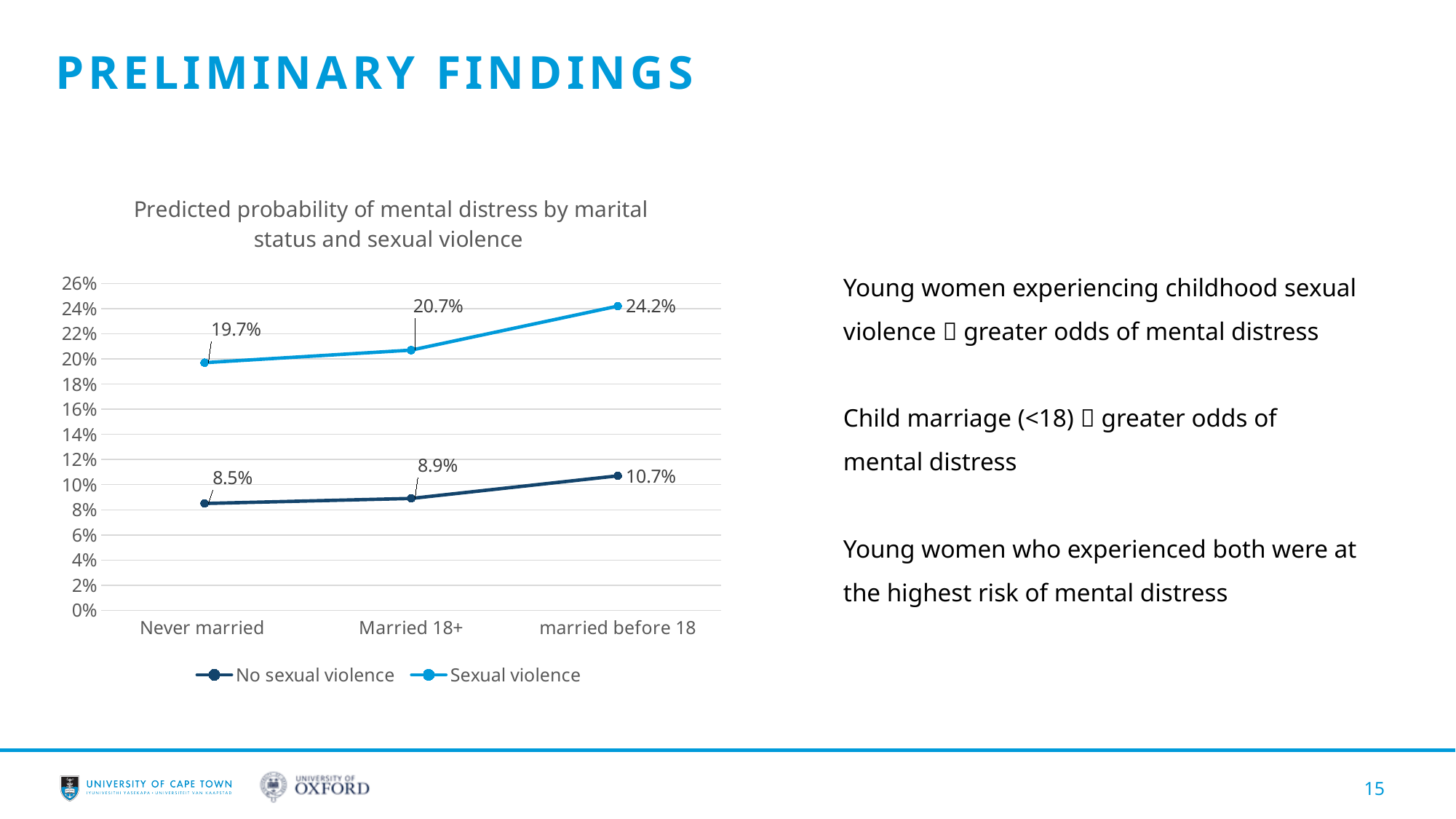
What is the predicted probability of mental distress for 'Sexual violence' among those married before 18? 24.2% How many series does the legend list? 2 What is the difference between the 'Sexual violence' and 'No sexual violence' values for those married before 18? 13.5% What is the predicted probability of mental distress for 'No sexual violence' among those never married? 8.5% What kind of chart is shown on the slide? line chart How many marital status categories are shown on the x axis? 3 Is the 'Sexual violence' value for 'Never married' greater or less than 18%? greater Which marital status category has the highest value for the 'No sexual violence' series? married before 18 Which marital status category has the lowest value for the 'Sexual violence' series? Never married What is the value for 'Sexual violence' in the 'Married 18+' category? 20.7% Do the values for the 'Sexual violence' series rise or fall from 'Never married' to 'married before 18'? rise Which is larger: the 'No sexual violence' value for 'Married 18+' or for 'Never married'? Married 18+